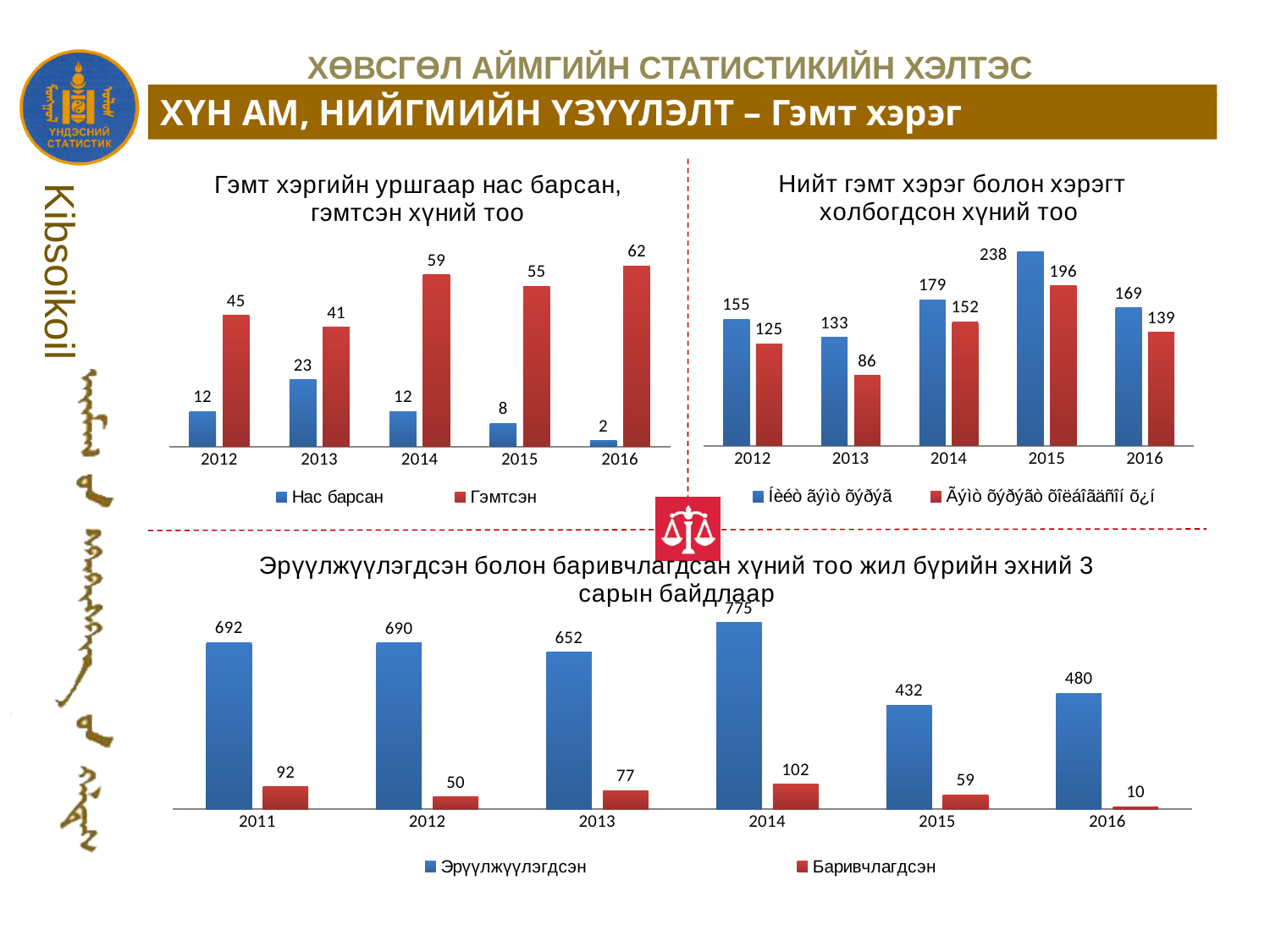
What kind of chart is the bottom chart 'Эрүүлжүүлэгдсэн болон баривчлагдсан хүний тоо'? Bar chart In the top-right chart 'Нийт гэмт хэрэг болон хэрэгт холбогдсон хүний тоо', what is the value of the blue bar for 2015? 238 In the top-left chart 'Гэмт хэргийн уршгаар нас барсан, гэмтсэн хүний тоо', what is the value for Гэмтсэн in 2014? 59 In the top-right chart 'Нийт гэмт хэрэг болон хэрэгт холбогдсон хүний тоо', what is the difference between the blue and red bars in 2014? 27 In the top-left chart 'Гэмт хэргийн уршгаар нас барсан, гэмтсэн хүний тоо', how many series does the legend list? 2 In the bottom chart 'Эрүүлжүүлэгдсэн болон баривчлагдсан хүний тоо', which is larger: Эрүүлжүүлэгдсэн in 2015 or in 2016? 2016 In the bottom chart 'Эрүүлжүүлэгдсэн болон баривчлагдсан хүний тоо', what is the value for Баривчлагдсэн in 2014? 102 In the top-right chart 'Нийт гэмт хэрэг болон хэрэгт холбогдсон хүний тоо', how many years are shown on the x axis? 5 In the bottom chart 'Эрүүлжүүлэгдсэн болон баривчлагдсан хүний тоо', which year has the highest value for Эрүүлжүүлэгдсэн? 2014 In the top-left chart 'Гэмт хэргийн уршгаар нас барсан, гэмтсэн хүний тоо', which year has the lowest value for Нас барсан? 2016 In the top-left chart 'Гэмт хэргийн уршгаар нас барсан, гэмтсэн хүний тоо', what is the difference between Гэмтсэн and Нас барсан in 2013? 18 In the top-right chart 'Нийт гэмт хэрэг болон хэрэгт холбогдсон хүний тоо', which year has the lowest red bar? 2013